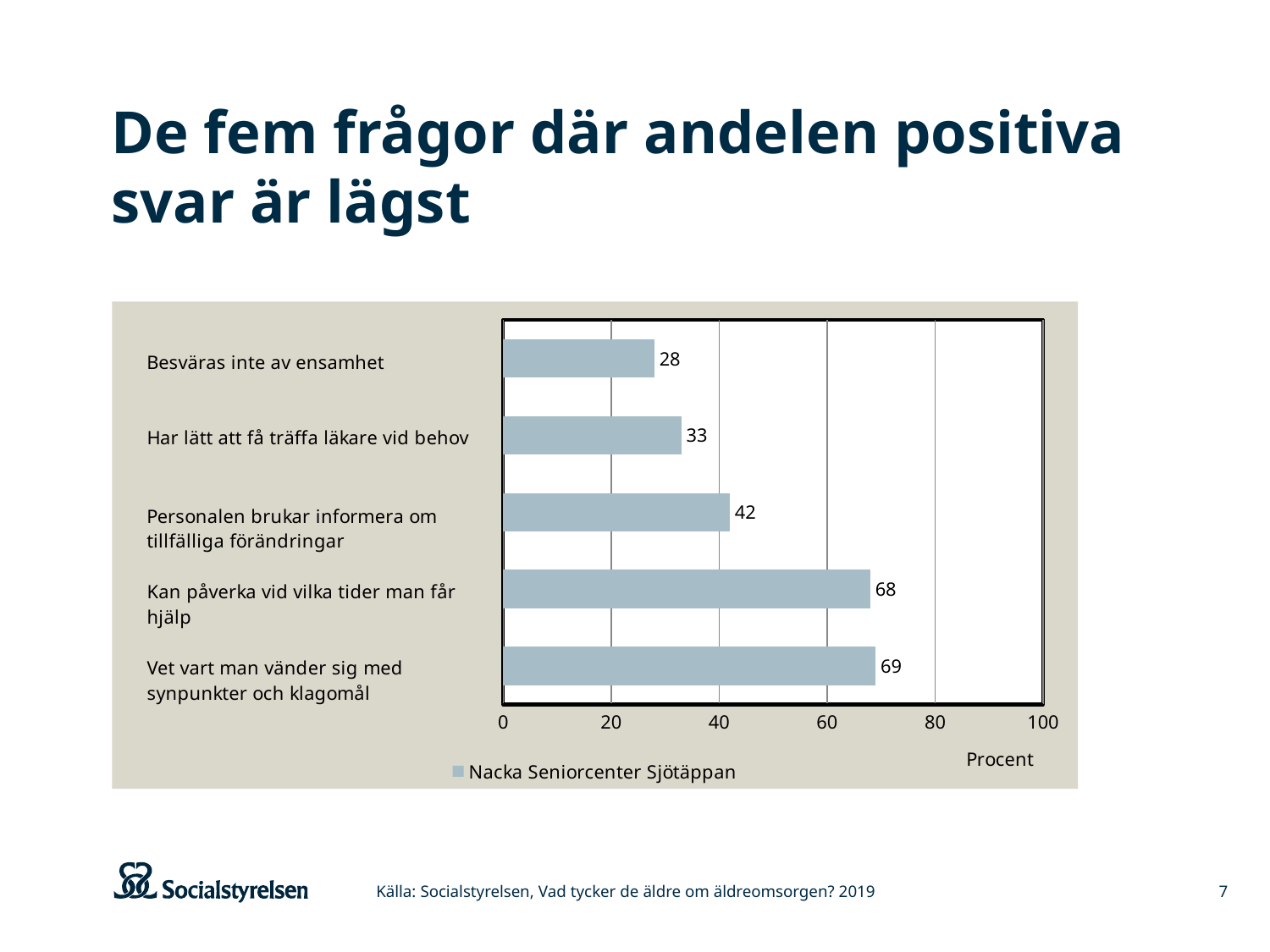
How many categories are shown in the chart? 5 Is the value for "Vet vart man vänder sig med synpunkter och klagomål" greater or less than 60? greater What is the difference between the values for "Kan påverka vid vilka tider man får hjälp" and "Personalen brukar informera om tillfälliga förändringar"? 26 What is the value for "Kan påverka vid vilka tider man får hjälp"? 68 What is the value for "Har lätt att få träffa läkare vid behov"? 33 What is the value for "Besväras inte av ensamhet"? 28 What series name does the legend show? Nacka Seniorcenter Sjötäppan What kind of chart is shown on the slide? bar chart Which is larger, the value for "Har lätt att få träffa läkare vid behov" or the value for "Personalen brukar informera om tillfälliga förändringar"? Personalen brukar informera om tillfälliga förändringar What is the value for "Personalen brukar informera om tillfälliga förändringar"? 42 Which category has the lowest value? Besväras inte av ensamhet Which category has the highest value? Vet vart man vänder sig med synpunkter och klagomål